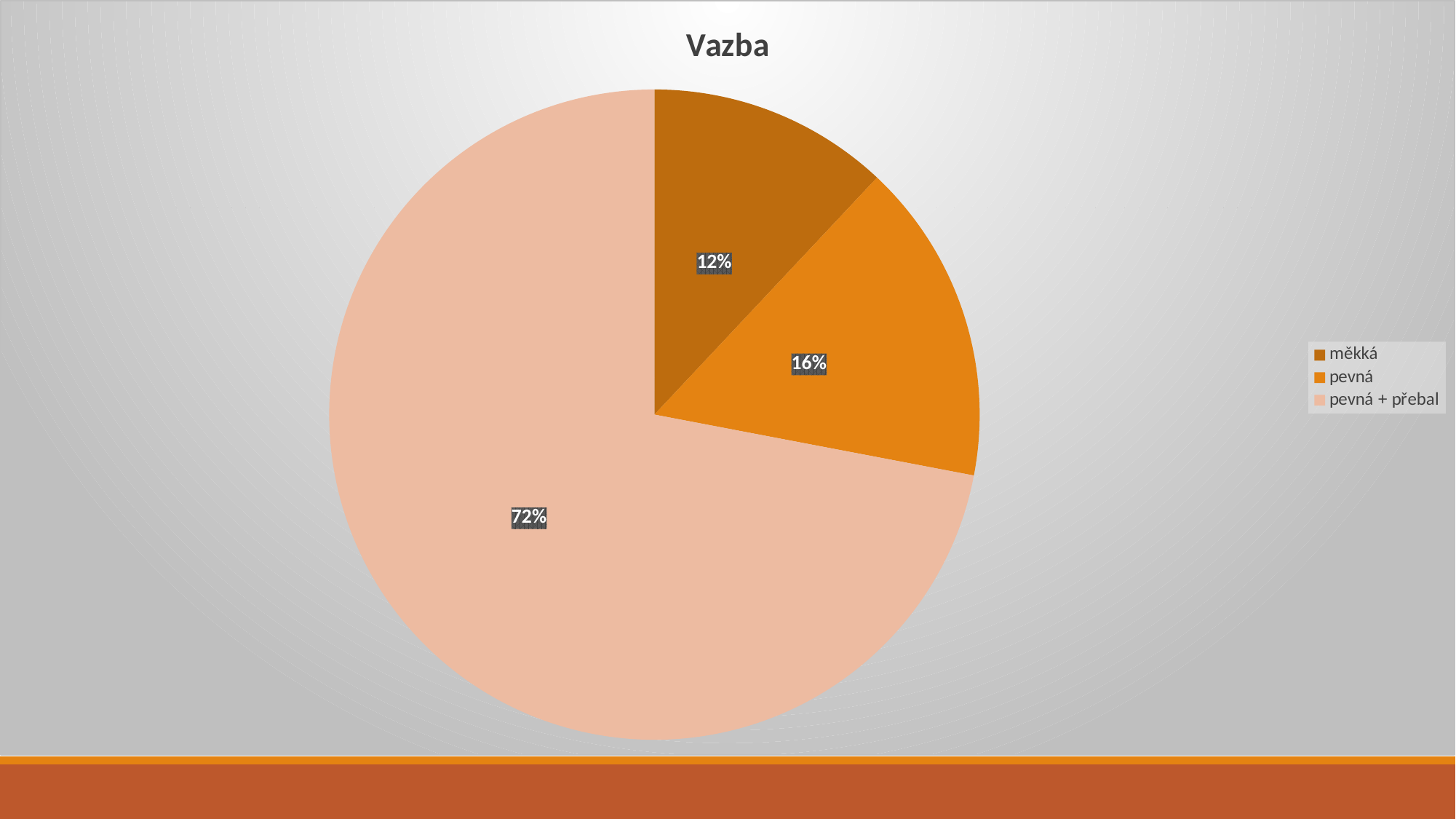
What is the difference between the 'pevná + přebal' and 'pevná' shares? 56% What kind of chart is shown on the slide? pie chart What is the value shown for 'měkká'? 12% What share of the pie does the 'pevná + přebal' slice represent? 72% Which category has the largest slice of the pie? pevná + přebal How many categories does the pie chart have? 3 What is the value shown for 'pevná'? 16% Which is larger, the 'pevná' slice or the 'měkká' slice? pevná How many entries does the legend list? 3 What is the difference between the 'pevná' and 'měkká' shares? 4% What is the title of the chart? Vazba Which category has the smallest slice of the pie? měkká